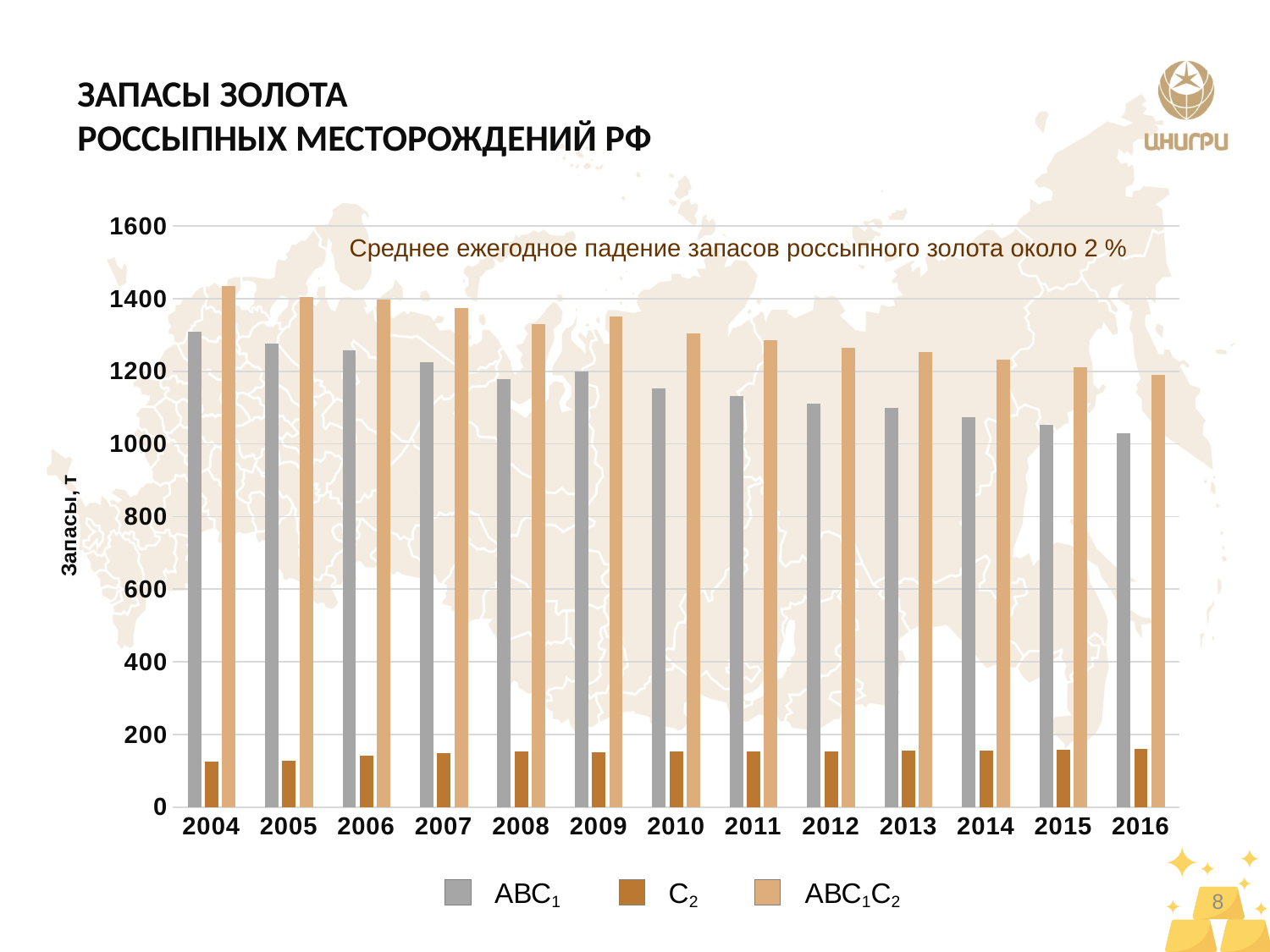
What is the label of the vertical axis of the chart? Запасы, т In which year is the ABC1 series highest? 2004 In which year is the ABC1C2 series highest? 2004 Do the ABC1 values rise or fall from 2004 to 2016? fall Is the ABC1 value for 2016 greater or less than 1000? greater How many series does the chart legend list? 3 What kind of chart is shown on the slide? bar chart Is the C2 value for 2010 greater or less than 200? less How many years are shown on the x axis of the chart? 13 In which year is the ABC1 series lowest? 2016 Which is larger in 2010, the ABC1C2 value or the C2 value? ABC1C2 Is the ABC1C2 value for 2004 greater or less than 1400? greater